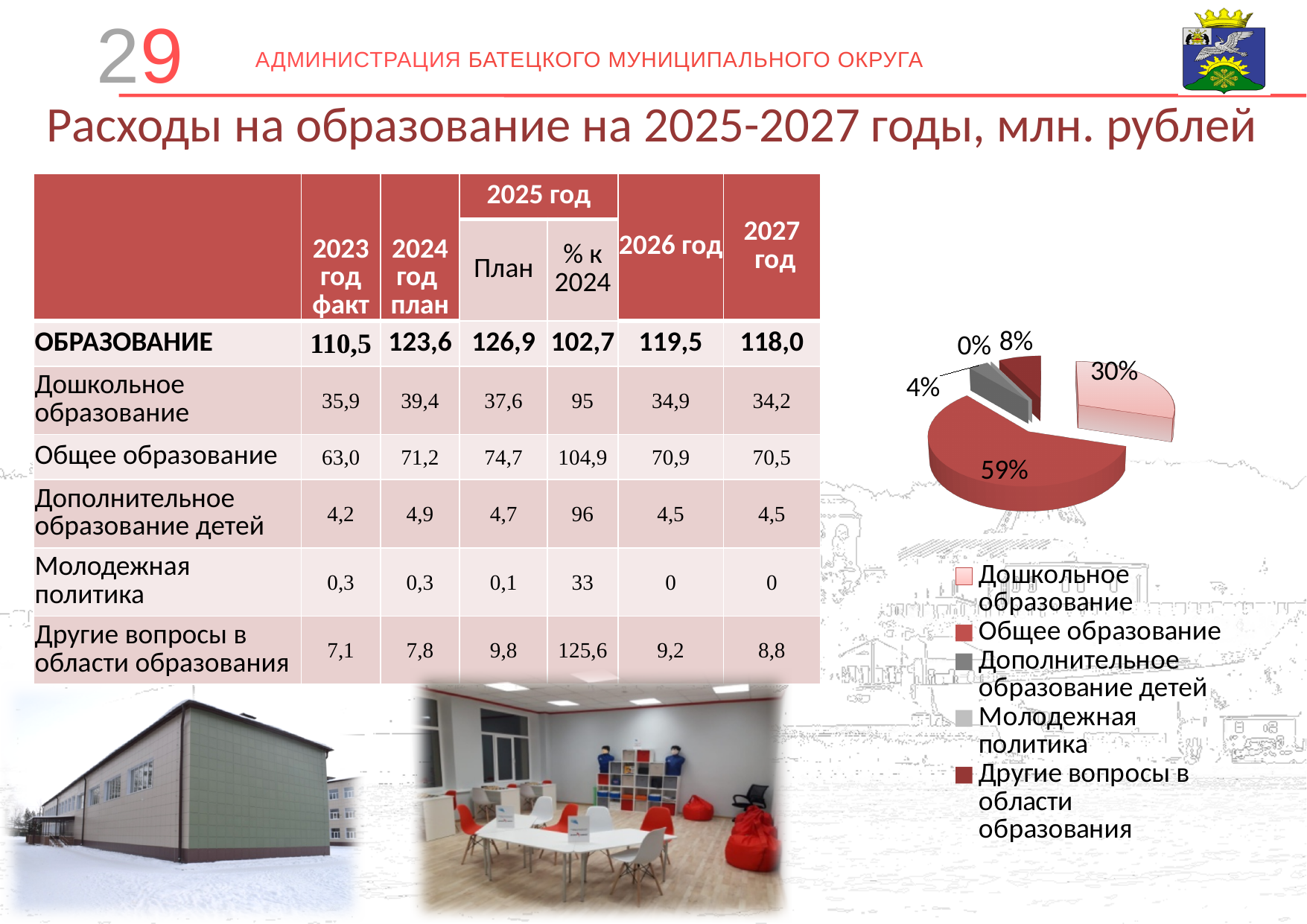
In the pie chart, what share does Другие вопросы в области образования have? 8% How many categories does the pie chart's legend list? 5 What kind of chart is shown on the right side of the slide? pie chart In the pie chart, what share does Дополнительное образование детей have? 4% In the pie chart, what is the difference in percentage points between Общее образование and Дошкольное образование? 29 In the pie chart, which slice is larger: Дошкольное образование or Другие вопросы в области образования? Дошкольное образование In the pie chart, what share does Молодежная политика have? 0% Which category has the smallest slice in the pie chart? Молодежная политика Which category has the largest slice in the pie chart? Общее образование Which legend entry in the pie chart is shown in light pink? Дошкольное образование In the pie chart, what share does Общее образование have? 59% In the pie chart, what share does Дошкольное образование have? 30%